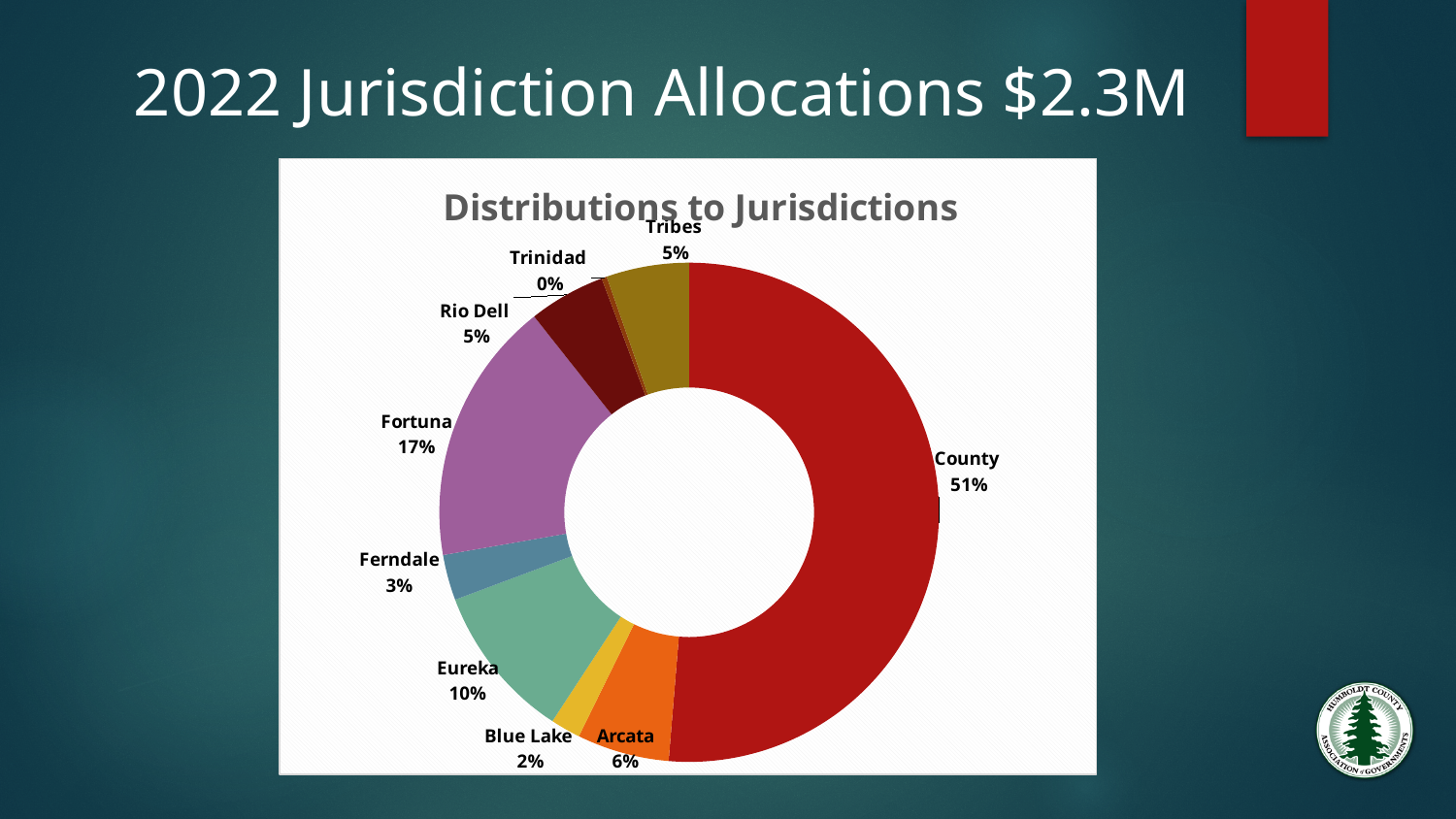
What share of the distributions does Fortuna receive? 17% What percentage of the distributions goes to Ferndale? 3% What kind of chart is shown on the slide? Doughnut chart Which jurisdiction receives the smallest share of the distributions? Trinidad What percentage is shown for Eureka? 10% How many jurisdictions are shown in the chart? 9 What percentage of the distributions goes to County? 51% How many percentage points larger is County's share than Fortuna's share? 34% Which jurisdiction receives the largest share of the distributions? County What percentage is shown for Arcata? 6% Which receives a larger share, Eureka or Arcata? Eureka What is the title of the chart? Distributions to Jurisdictions